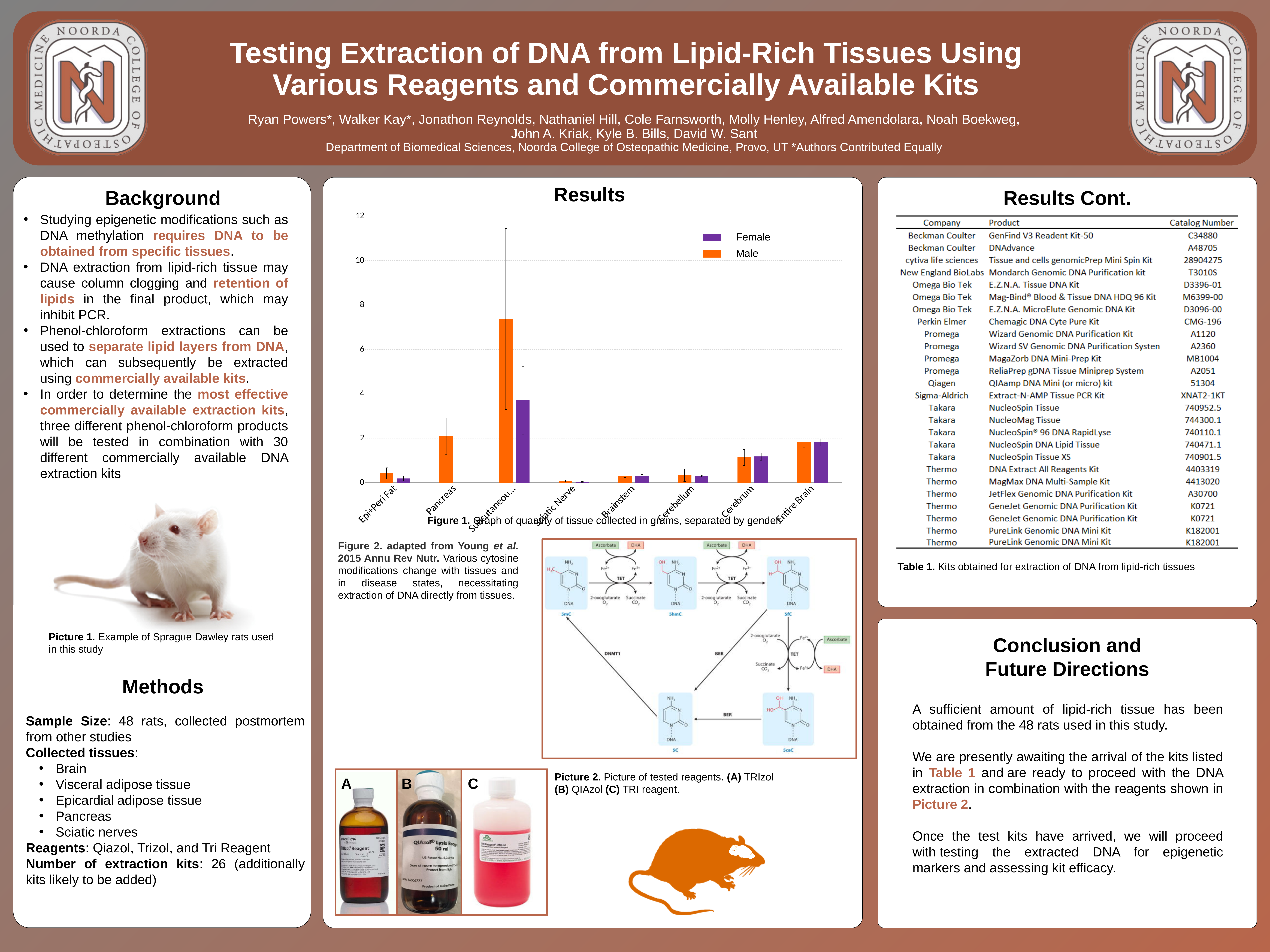
In the Figure 1 bar chart, is the Female value for Subcutaneou... greater or less than 4? less How many tissue categories are shown along the x axis of the Figure 1 bar chart? 8 In the Figure 1 bar chart, which tissue category has the lowest Male value? Sciatic Nerve In the Figure 1 bar chart, is the Male value for Subcutaneou... greater or less than 6? greater In the Figure 1 bar chart, what colour represents the Male series? orange How many series does the legend of the Figure 1 bar chart list? 2 Which two series are listed in the legend of the Figure 1 bar chart? Female and Male In the Figure 1 bar chart, which tissue category has the highest Female value? Subcutaneou... What kind of chart is shown in Figure 1 on the slide? bar chart In the Figure 1 bar chart, which is larger for Subcutaneou..., the Male value or the Female value? Male In the Figure 1 bar chart, which tissue category has the highest Male value? Subcutaneou... In the Figure 1 bar chart, is the Male value for Pancreas greater or less than 4? less